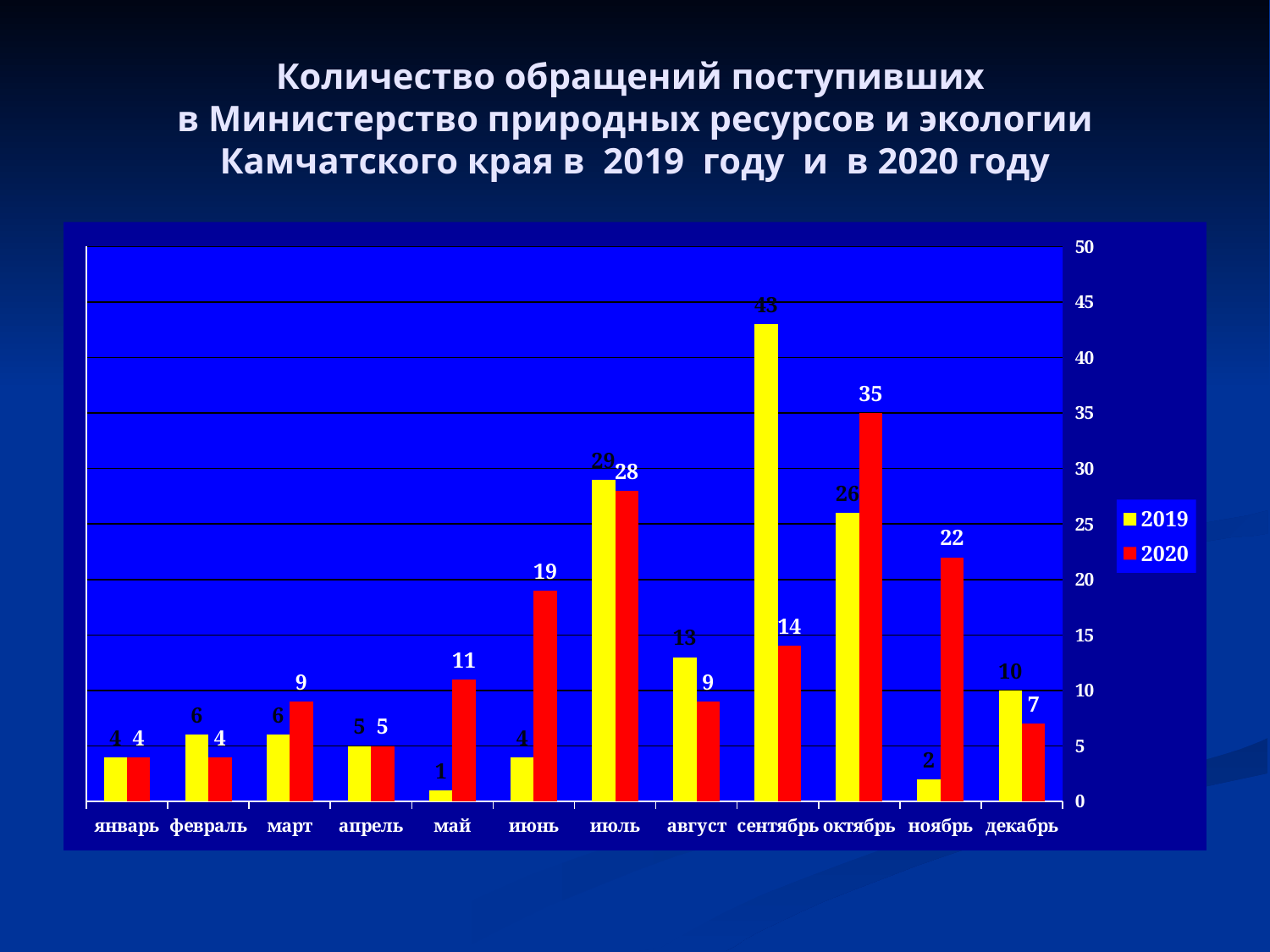
What is the total of the 2019 and 2020 values in июль? 57 How many months (categories) are shown on the x axis? 12 Which is larger in август: the 2019 value or the 2020 value? 2019 How many series does the legend list? 2 What is the value for 2019 in сентябрь? 43 What is the value for 2020 in июнь? 19 In which month is the 2019 value lowest? май What type of chart is shown on the slide? Bar chart Which colour represents the 2020 series in the legend? Red In which month is the 2020 value highest? октябрь What is the difference between the 2020 and 2019 values in октябрь? 9 What is the value for 2020 in ноябрь? 22